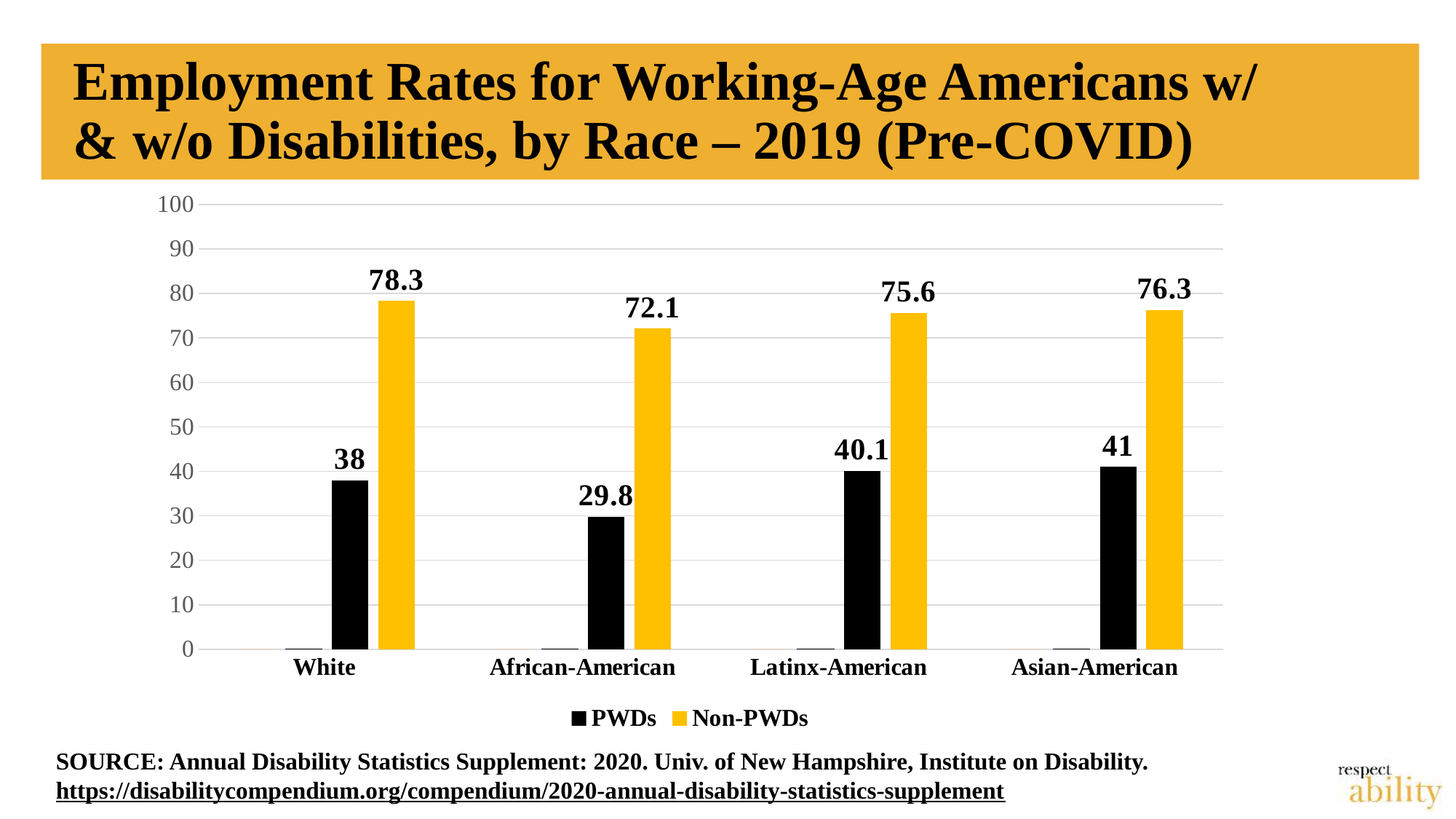
How many race categories are shown on the x axis? 4 Which is larger: the PWDs employment rate for Asian-American or for Latinx-American? Asian-American How many series does the legend list? 2 What is the employment rate for Non-PWDs in the Asian-American category? 76.3 What is the difference between the Non-PWDs and PWDs employment rates for the White category? 40.3 Which race category has the highest Non-PWDs employment rate? White Which race category has the lowest PWDs employment rate? African-American What is the employment rate for PWDs in the Latinx-American category? 40.1 Which colour represents the Non-PWDs series? Yellow What kind of chart is shown on the slide? Bar chart What is the employment rate for PWDs in the White category? 38 What is the employment rate for Non-PWDs in the African-American category? 72.1